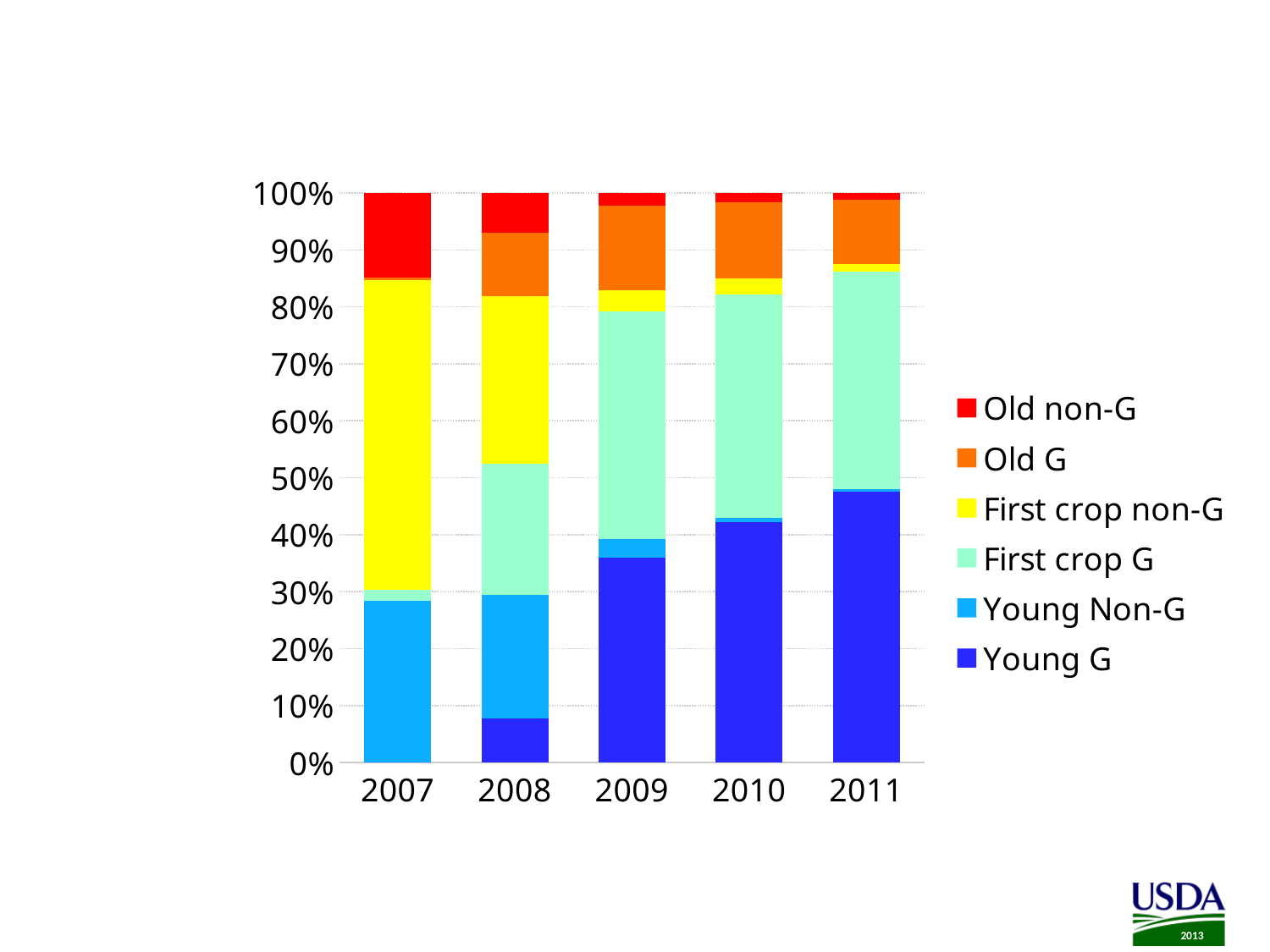
Is the Young G share in 2009 greater or less than 30%? greater Does the Young G share rise or fall from 2008 to 2011? rise Is the First crop non-G share in 2007 greater or less than 50%? greater How many series does the legend list? 6 Which colour represents Old non-G in the legend? red Which year has the largest Young G share? 2011 How many years are shown on the x axis of the chart? 5 Is the Young Non-G share in 2007 greater or less than 20%? greater Which year has the largest First crop non-G share? 2007 Is the Young G share larger in 2008 or in 2011? 2011 What kind of chart is shown on the slide? stacked bar chart